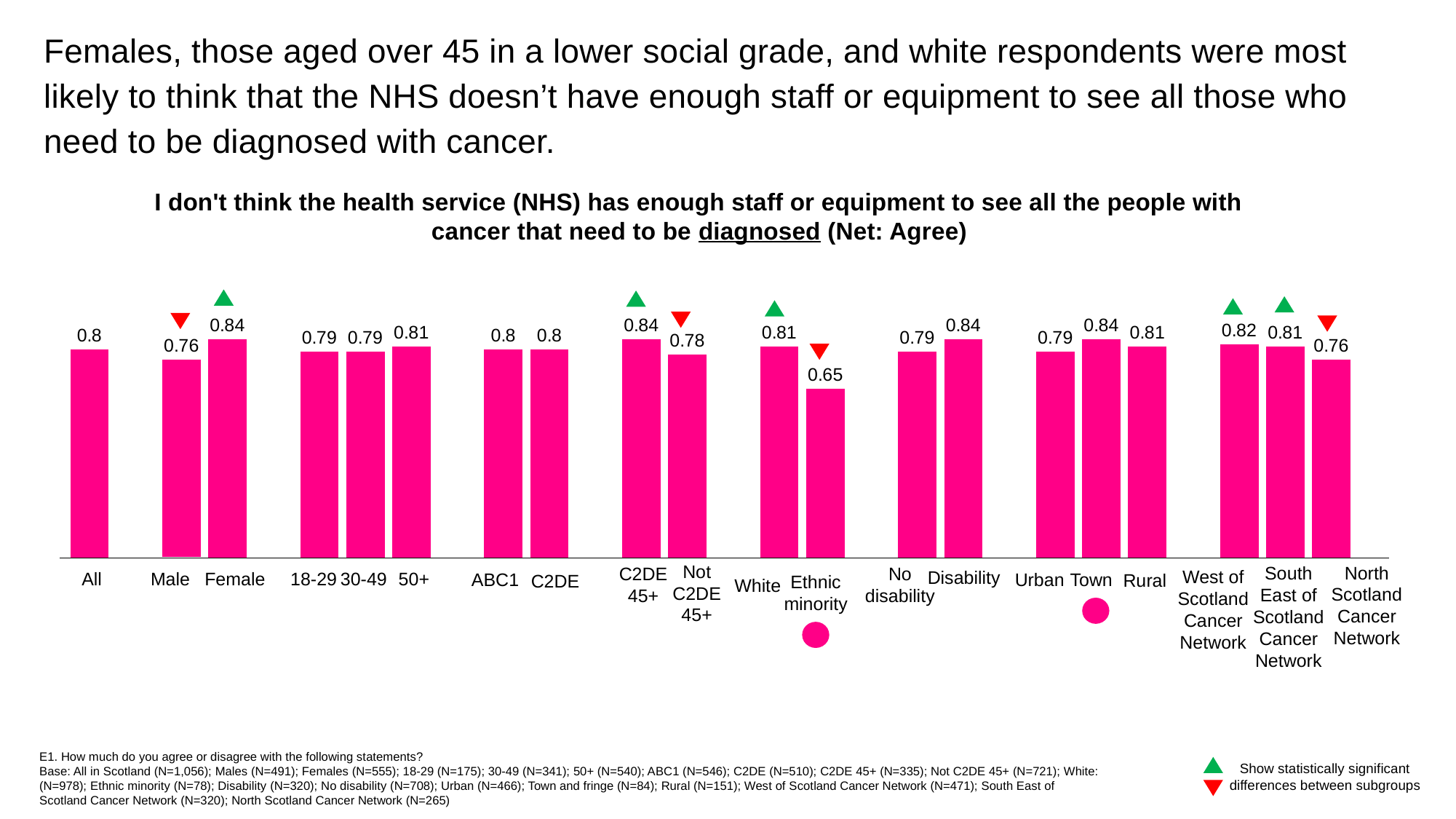
Which category has the lowest value? Ethnic minority What is the highest value shown on the chart? 0.84 Which is larger, the value for Disability or the value for No disability? Disability What is the value for North Scotland Cancer Network? 0.76 Which is larger, the value for C2DE 45+ or the value for Not C2DE 45+? C2DE 45+ What is the difference between the values for White and Ethnic minority? 0.16 What kind of chart is shown on the slide? Bar chart What is the value for Ethnic minority? 0.65 What is the difference between the values for Female and Male? 0.08 What is the value for All? 0.8 How many bars are shown on the chart? 20 What is the value for Female? 0.84